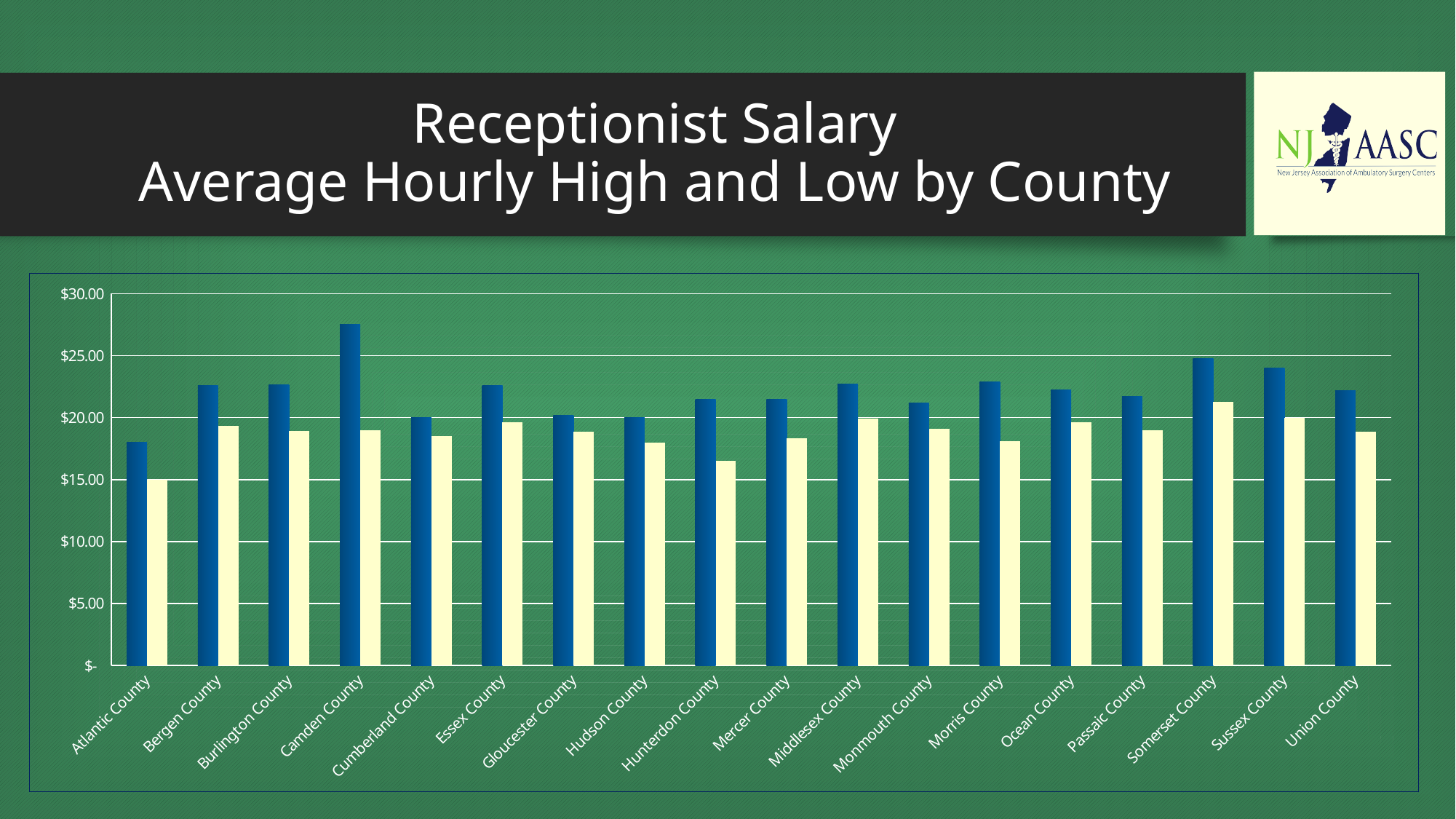
Which county has the shortest pale yellow bar in the chart? Atlantic County What is the title shown above the chart? Receptionist Salary Average Hourly High and Low by County Which is taller, the pale yellow bar for Somerset County or the pale yellow bar for Hunterdon County? Somerset County Is the blue bar for Atlantic County greater or less than $20.00? less Is the blue bar for Camden County greater or less than $25.00? greater Which is taller, the blue bar for Camden County or the blue bar for Sussex County? Camden County Which county has the tallest blue bar in the chart? Camden County What kind of chart is shown on the slide? bar chart Is the pale yellow bar for Hunterdon County greater or less than $20.00? less How many counties are shown along the x axis of the chart? 18 Which county has the shortest blue bar in the chart? Atlantic County Which county has the tallest pale yellow bar in the chart? Somerset County